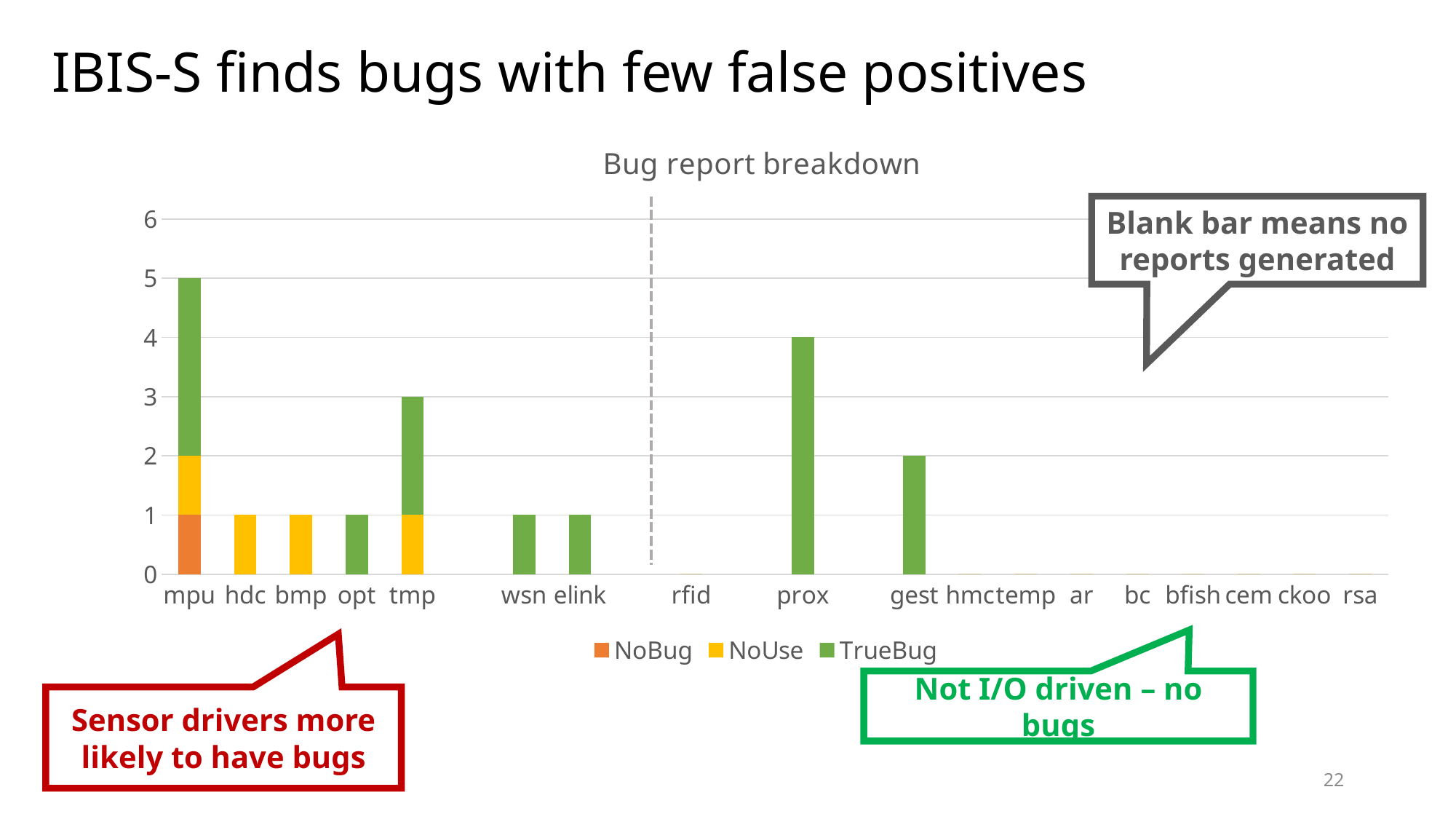
What is the NoUse value for hdc? 1 What is the difference between the TrueBug value for prox and the TrueBug value for gest? 2 What is the TrueBug value for gest? 2 What is the total height of the stacked bar for tmp? 3 Which category is the only one with a NoBug segment? mpu What kind of chart is shown on the slide? stacked bar chart What is the total height of the stacked bar for mpu? 5 Which is larger, the total bar for tmp or the total bar for opt? tmp How many series does the chart legend list? 3 Which category has the tallest stacked bar? mpu What is the TrueBug value for prox? 4 What is the title of the chart? Bug report breakdown